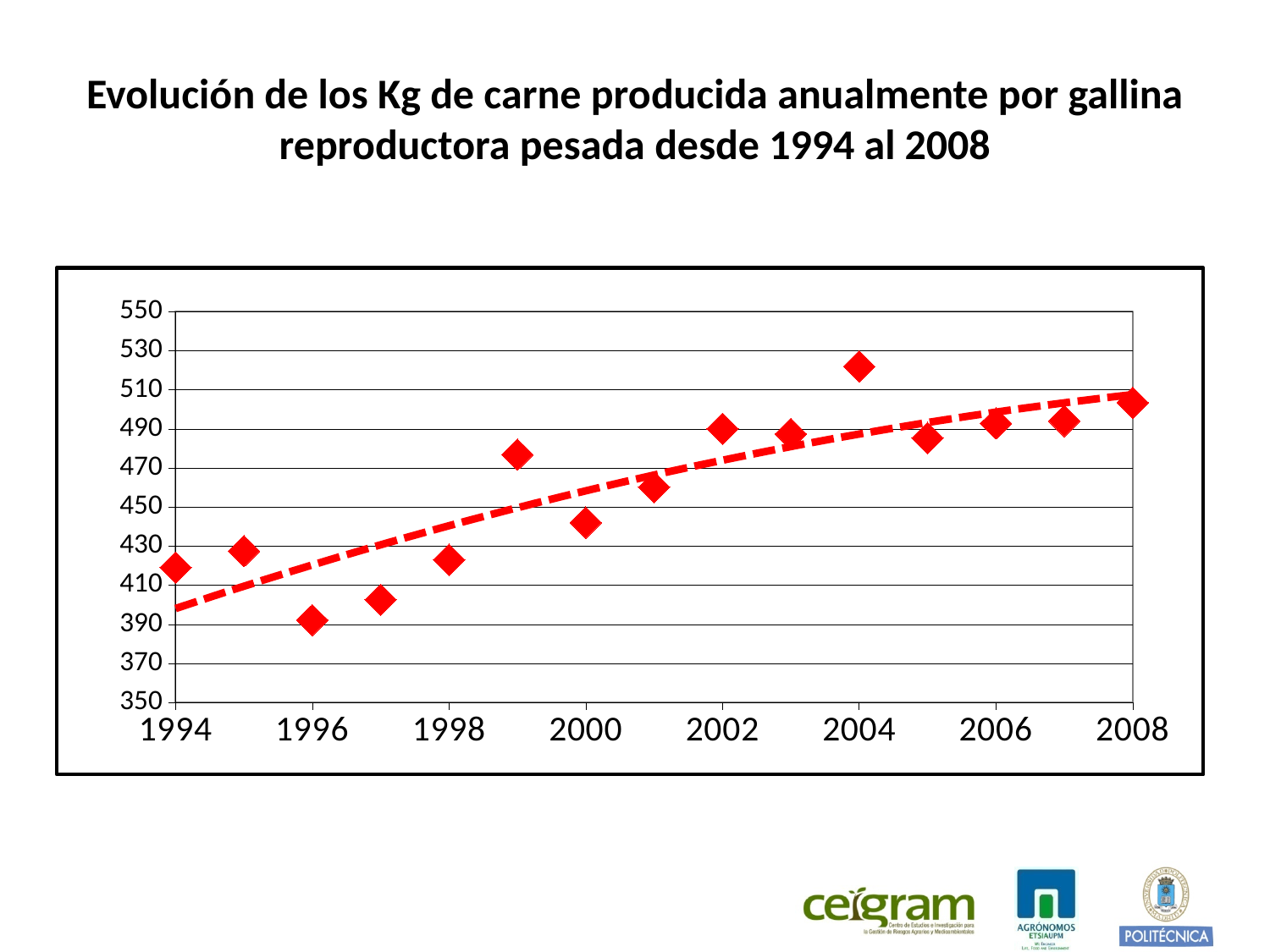
What is the first year shown on the x axis? 1994 Which year has the highest plotted value? 2004 Is the value for 1996 greater or less than 410? less How many data points are plotted on the chart? 15 Is the value for 2004 greater or less than 510? greater Which year has the lowest plotted value? 1996 What kind of chart is shown on the slide? scatter chart Is the value for 2000 greater or less than 450? less Which year has the larger value, 1999 or 2000? 1999 Do the plotted values generally rise or fall from 1994 to 2008? rise Which year has the larger value, 2004 or 2005? 2004